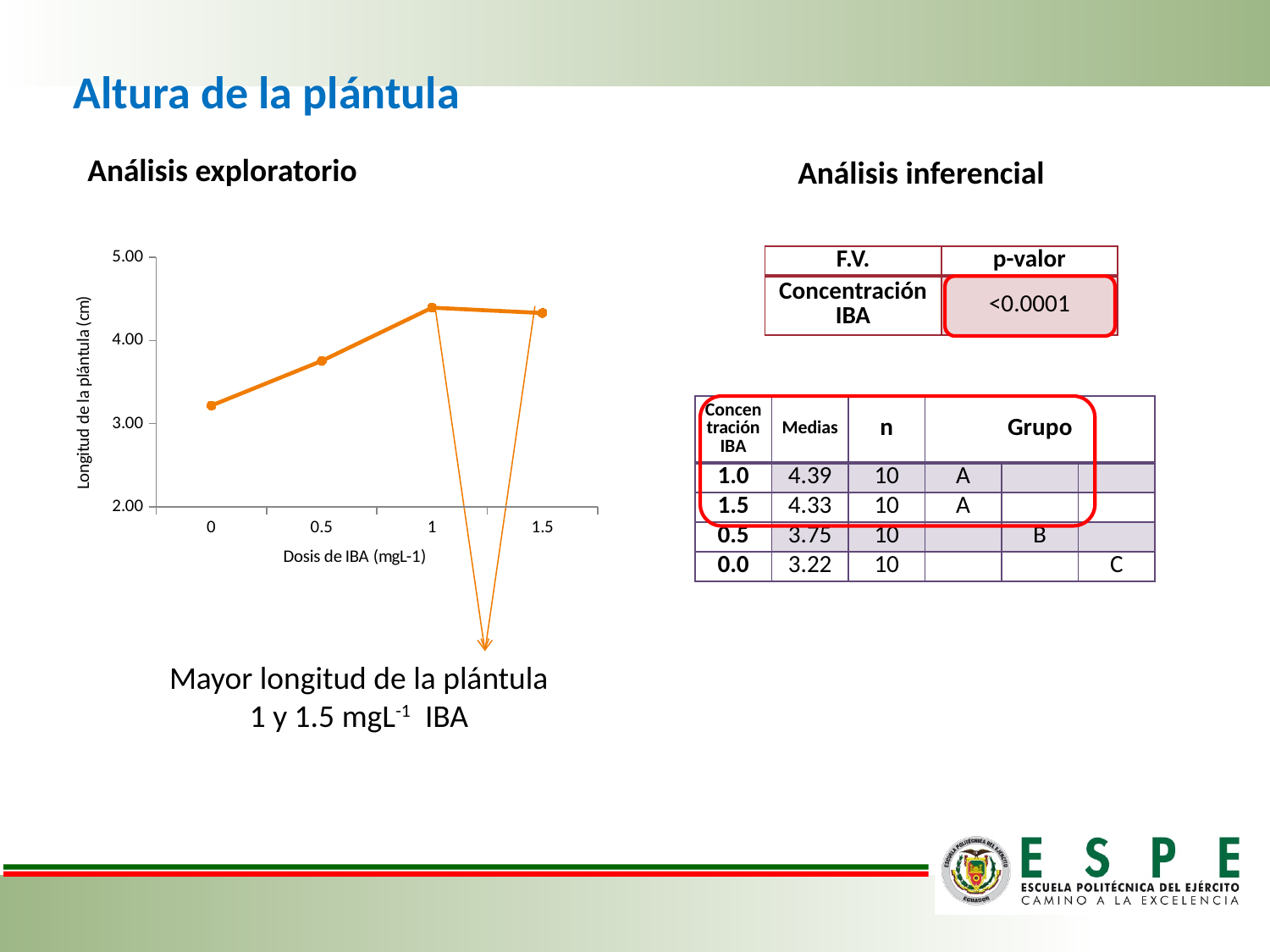
Which IBA dose has the lowest plant length on the line chart? 0 What is the title of the x axis of the line chart? Dosis de IBA (mgL-1) Is the value for dose 1.5 greater or less than 4.00? greater Which has a larger plant length on the line chart, dose 0 or dose 0.5? 0.5 Do the values on the line chart rise or fall from dose 0 to dose 1? rise How many data points are plotted on the line chart? 4 Is the value for dose 0.5 greater or less than 4.00? less What kind of chart is shown under 'Análisis exploratorio'? line chart Which has a larger plant length on the line chart, dose 0.5 or dose 1? 1 Is the value for dose 0 greater or less than 3.00? greater What is the title of the y axis of the line chart? Longitud de la plántula (cm)